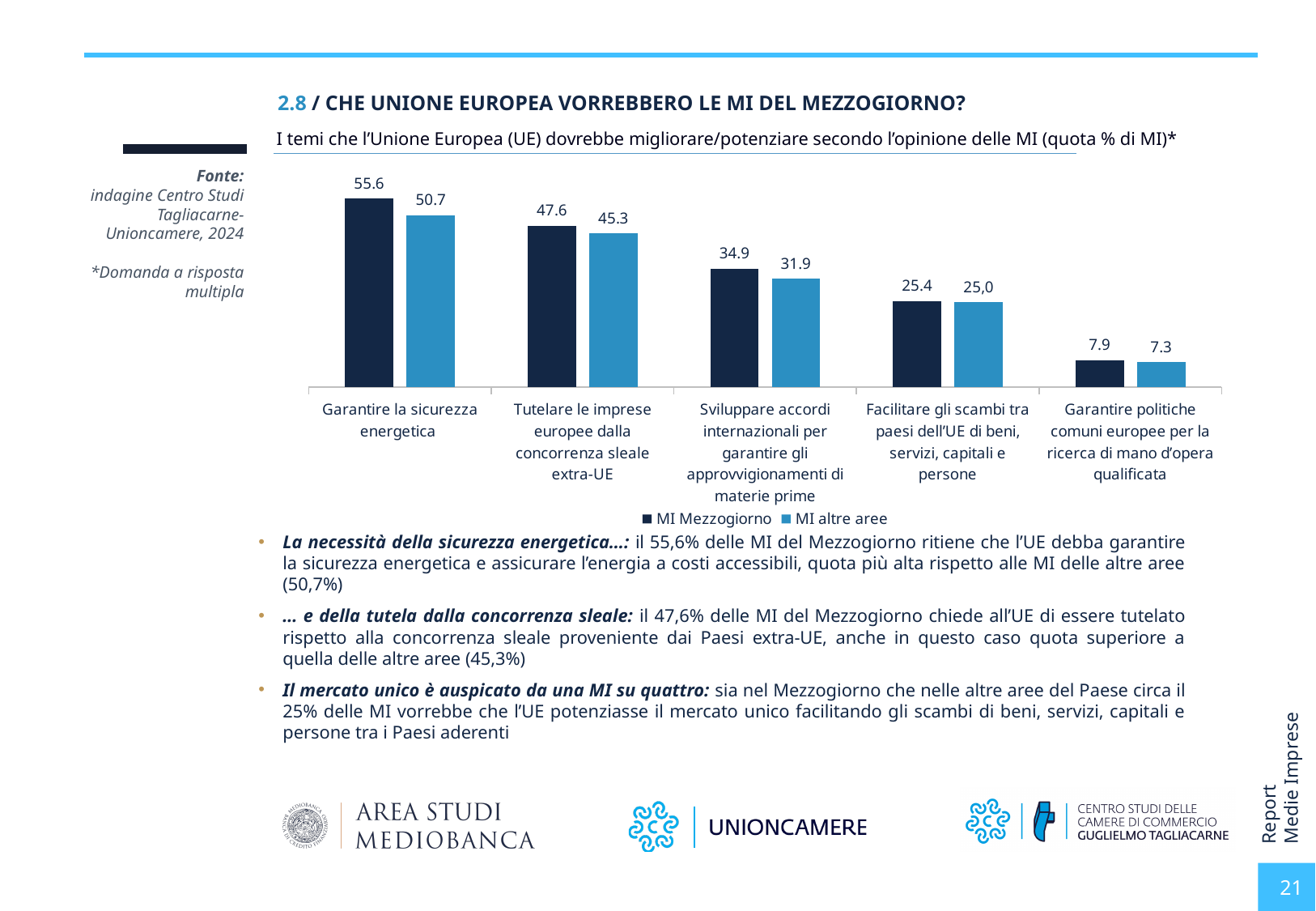
What kind of chart is shown on the slide? Bar chart Which category has the highest value for MI Mezzogiorno? Garantire la sicurezza energetica What is the value for MI Mezzogiorno for "Garantire la sicurezza energetica"? 55.6 Do the values for MI Mezzogiorno rise or fall from left to right along the x axis? Fall Which series is shown in dark navy in the legend? MI Mezzogiorno How many series does the legend list? 2 For "Sviluppare accordi internazionali per garantire gli approvvigionamenti di materie prime", which series has the larger value, MI Mezzogiorno or MI altre aree? MI Mezzogiorno How many categories are shown on the x axis of the chart? 5 What is the difference between MI Mezzogiorno and MI altre aree for "Garantire la sicurezza energetica"? 4.9 What is the value for MI altre aree for "Facilitare gli scambi tra paesi dell'UE di beni, servizi, capitali e persone"? 25,0 What is the value for MI altre aree for "Tutelare le imprese europee dalla concorrenza sleale extra-UE"? 45.3 Which category has the lowest value for MI altre aree? Garantire politiche comuni europee per la ricerca di mano d'opera qualificata